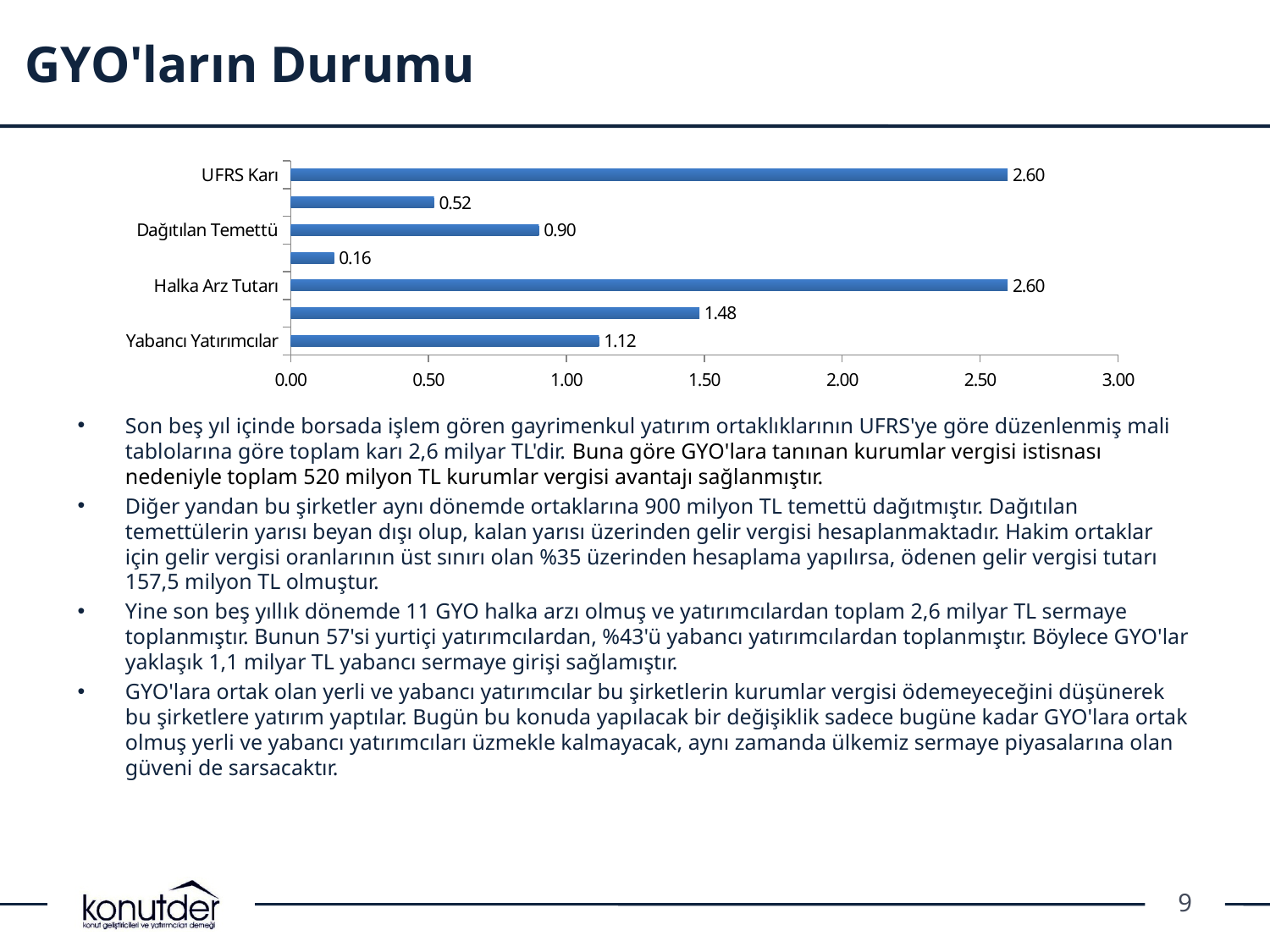
Which is larger, the value for Halka Arz Tutarı or the value for Yabancı Yatırımcılar? Halka Arz Tutarı What is the difference between the values for UFRS Karı and Dağıtılan Temettü? 1.70 What is the difference between the values for Halka Arz Tutarı and Yabancı Yatırımcılar? 1.48 What kind of chart is shown on the slide? Bar chart What is the value shown for Dağıtılan Temettü? 0.90 How many bars are plotted in the chart? 7 What is the value shown for Yabancı Yatırımcılar? 1.12 What is the value shown for Halka Arz Tutarı? 2.60 Which is larger, the value for Dağıtılan Temettü or the value for Yabancı Yatırımcılar? Yabancı Yatırımcılar Is the value for Dağıtılan Temettü greater or less than 1.00? less Is the value for UFRS Karı greater or less than 2.50? greater What is the value shown for UFRS Karı? 2.60